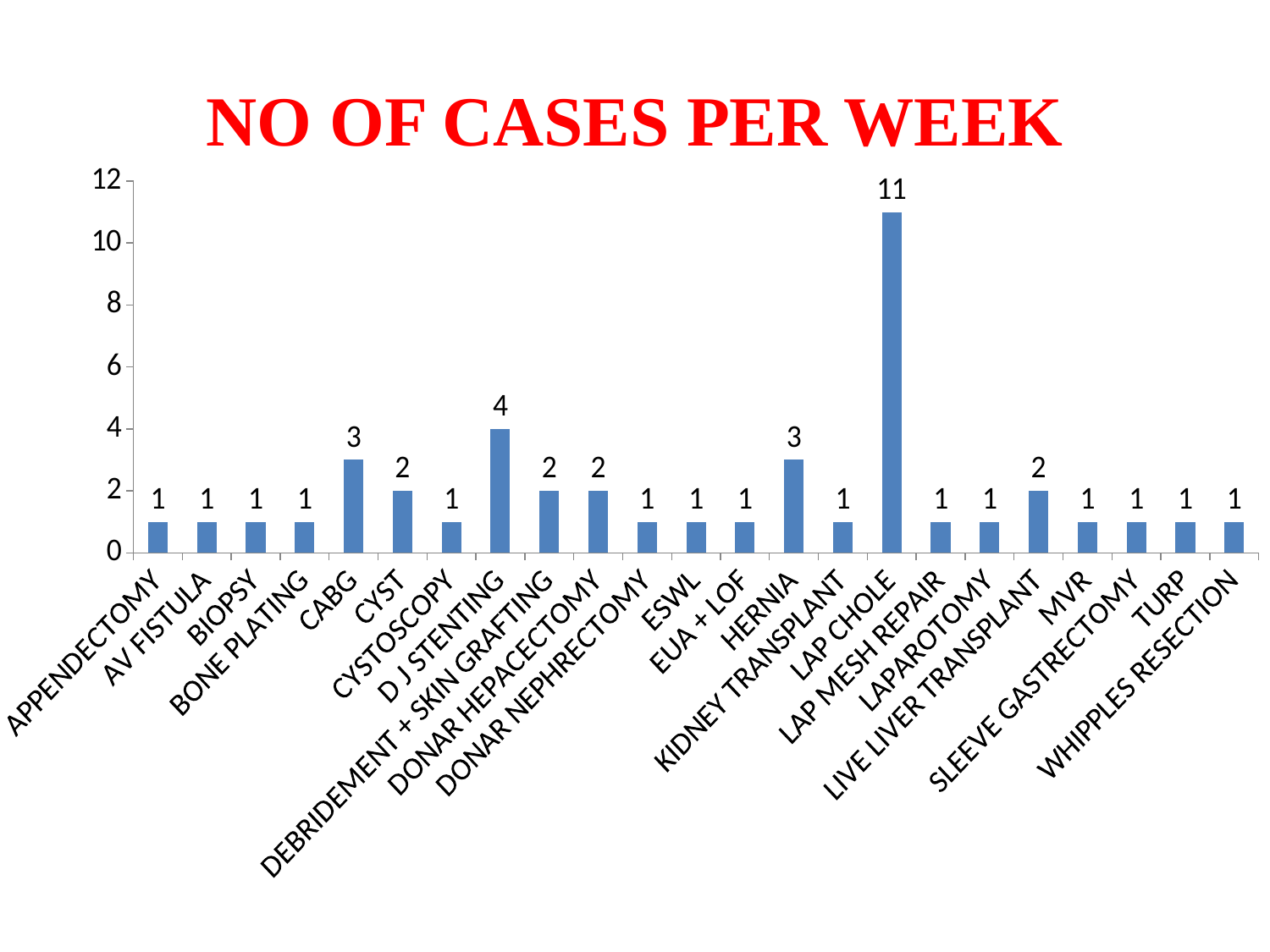
What kind of chart is shown on the slide? Bar chart What is the title of the chart? NO OF CASES PER WEEK What is the number of cases per week for LIVE LIVER TRANSPLANT? 2 What is the difference in cases per week between LAP CHOLE and D J STENTING? 7 Which procedure has the highest number of cases per week? LAP CHOLE How many procedure categories are shown on the x axis? 23 Which has more cases per week, D J STENTING or HERNIA? D J STENTING What is the number of cases per week for LAP CHOLE? 11 Is the value for LAP CHOLE greater or less than 10? greater What is the difference in cases per week between CABG and CYST? 1 What is the number of cases per week for HERNIA? 3 What is the number of cases per week for D J STENTING? 4